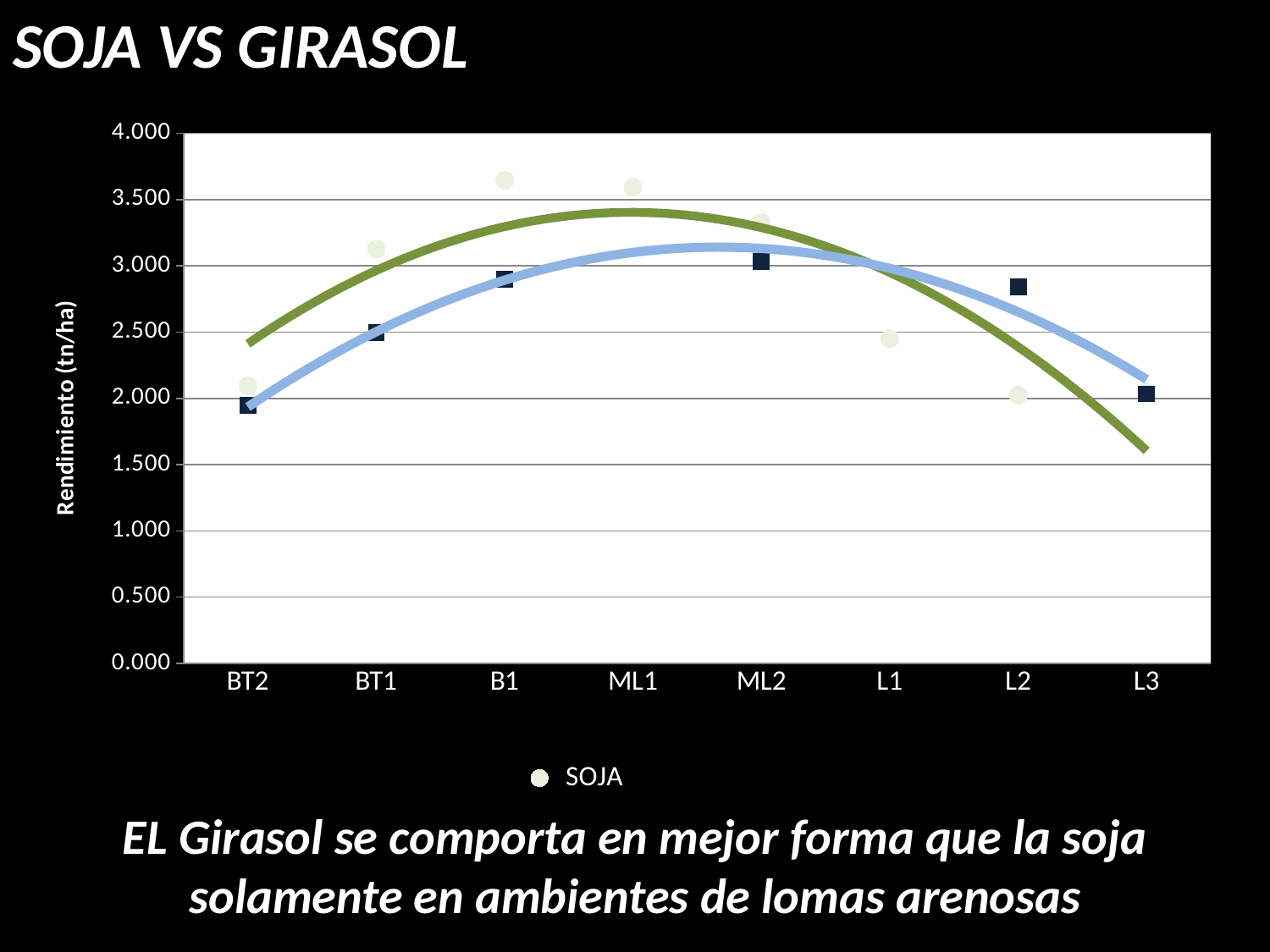
What is the title of the y axis? Rendimiento (tn/ha) Is the value of the dark square marker at L2 greater or less than 2.500? greater What kind of chart is shown on the slide? scatter chart Which series name appears in the legend? SOJA Do the SOJA values rise or fall from ML1 to L2 along the x axis? fall Is the SOJA value for BT2 greater or less than 2.500? less Is the SOJA value for B1 greater or less than 3.500? greater How many categories are shown on the x axis? 8 How many series does the legend list? 1 Which is larger, the SOJA value for B1 or the SOJA value for L1? B1